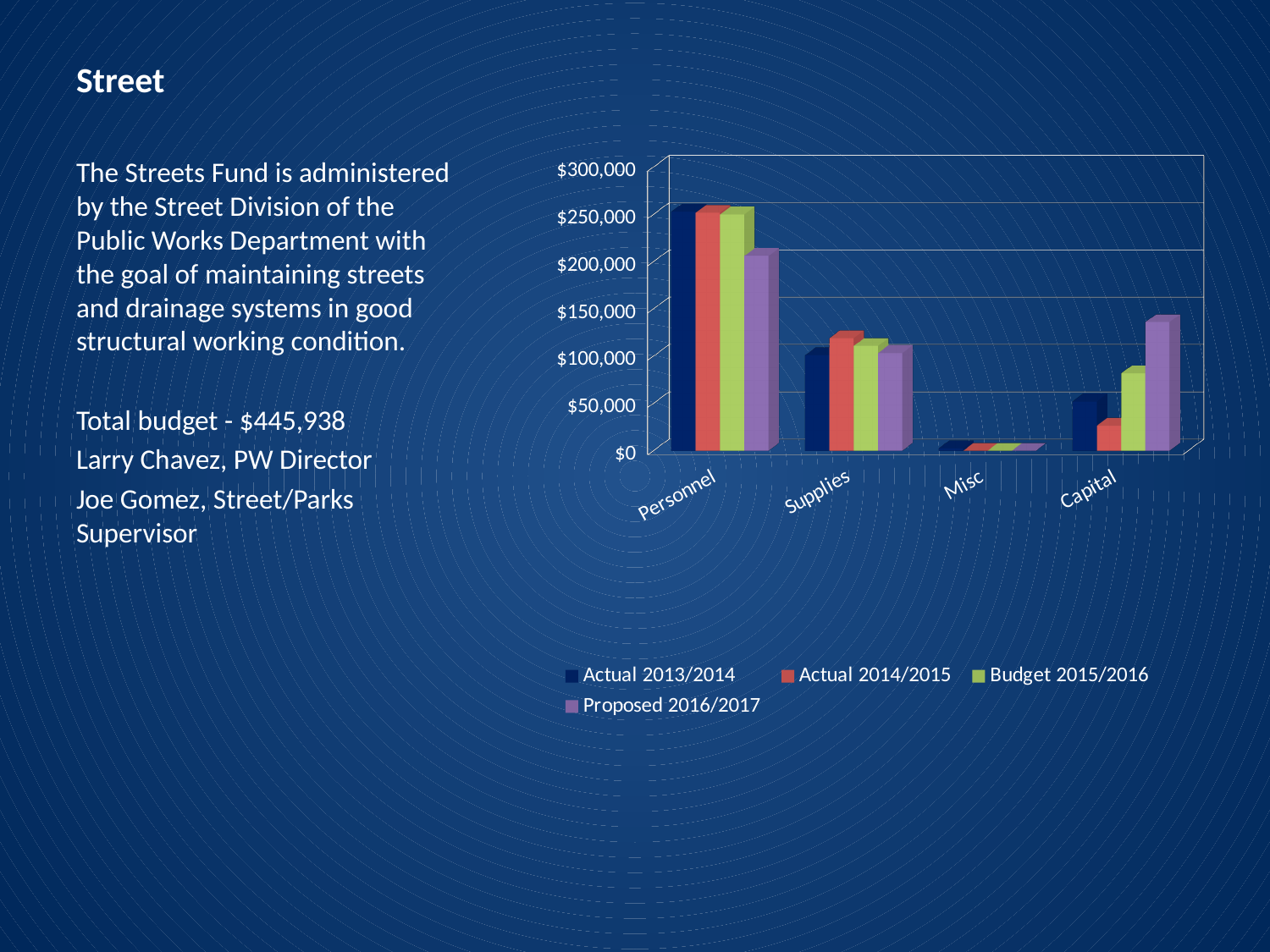
Is the Proposed 2016/2017 value for Capital greater or less than $100,000? greater For Personnel, which is larger: the Actual 2013/2014 value or the Proposed 2016/2017 value? Actual 2013/2014 How many categories are shown on the x axis of the chart? 4 How many series does the chart's legend list? 4 Is the Proposed 2016/2017 value for Personnel greater or less than $250,000? less Is the Actual 2013/2014 value for Personnel greater or less than $200,000? greater Which category has the lowest values in the chart? Misc What colour represents the Proposed 2016/2017 series in the chart? Purple What kind of chart is shown on the slide? Bar chart Which category has the highest values in the chart? Personnel For Capital, which series has the largest value? Proposed 2016/2017